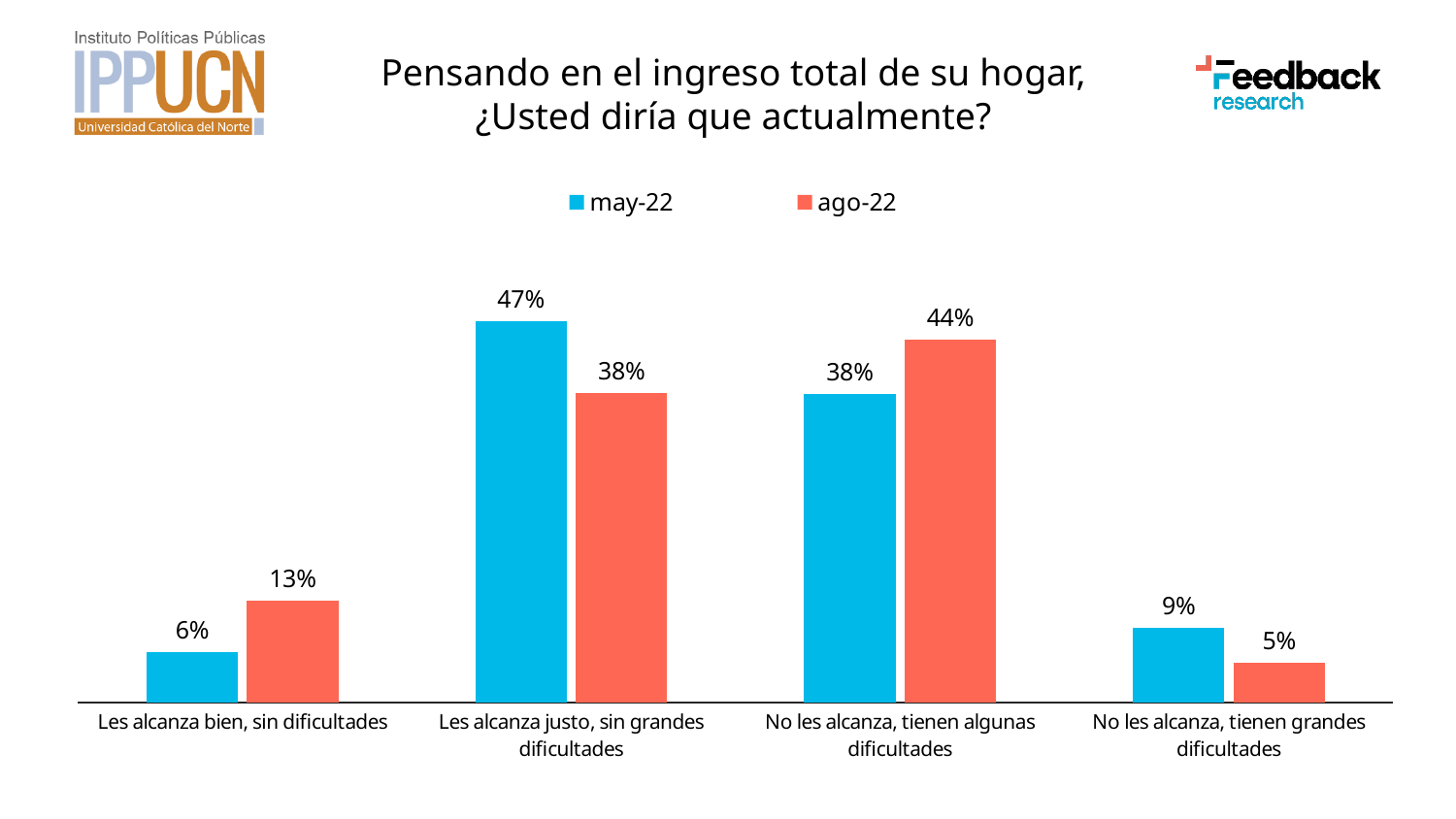
Which category has the lowest ago-22 value? No les alcanza, tienen grandes dificultades What is the difference between the may-22 and ago-22 values for "Les alcanza justo, sin grandes dificultades"? 9% Which category has the highest may-22 value? Les alcanza justo, sin grandes dificultades What is the ago-22 value for "No les alcanza, tienen algunas dificultades"? 44% How many series does the legend list? 2 What kind of chart is shown on the slide? Bar chart What is the ago-22 value for "Les alcanza bien, sin dificultades"? 13% What is the may-22 value for "Les alcanza justo, sin grandes dificultades"? 47% For "No les alcanza, tienen algunas dificultades", which series has the larger value, may-22 or ago-22? ago-22 What is the may-22 value for "No les alcanza, tienen grandes dificultades"? 9% What colour are the ago-22 bars? Red/orange How many categories are shown on the x axis? 4